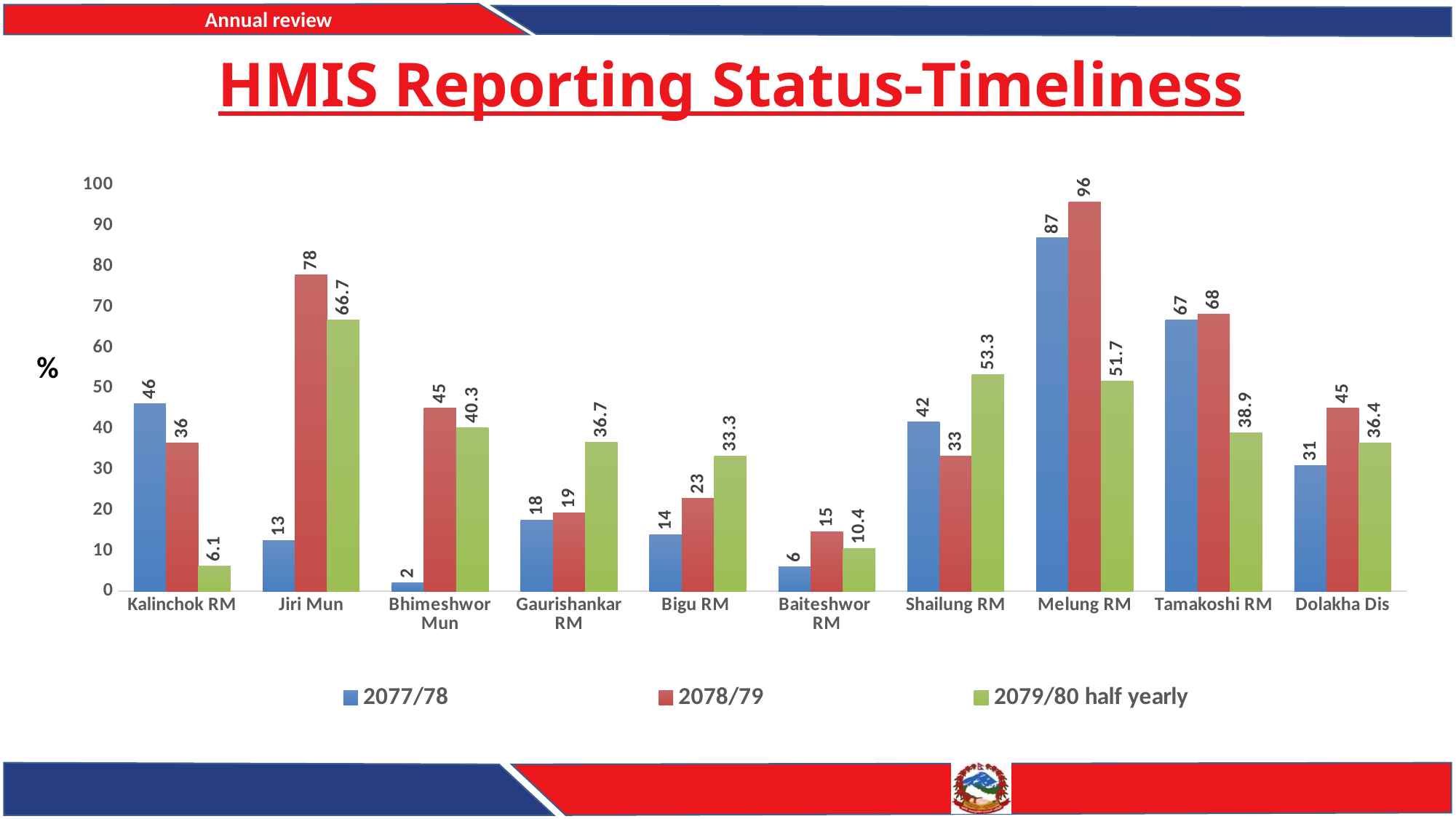
What is the 2077/78 value for Bhimeshwor Mun? 2 Which category has the highest 2077/78 value? Melung RM Which colour represents the 2079/80 half yearly series? Green Which category has the lowest 2079/80 half yearly value? Kalinchok RM How many categories are shown on the x axis? 10 Which is larger for Shailung RM: the 2077/78 value or the 2078/79 value? 2077/78 What kind of chart is shown on the slide? Bar chart What is the difference between the 2078/79 and 2077/78 values for Jiri Mun? 65 What is the 2079/80 half yearly value for Melung RM? 51.7 What is the title of the chart? HMIS Reporting Status-Timeliness How many series does the legend list? 3 What is the 2078/79 value for Jiri Mun? 78